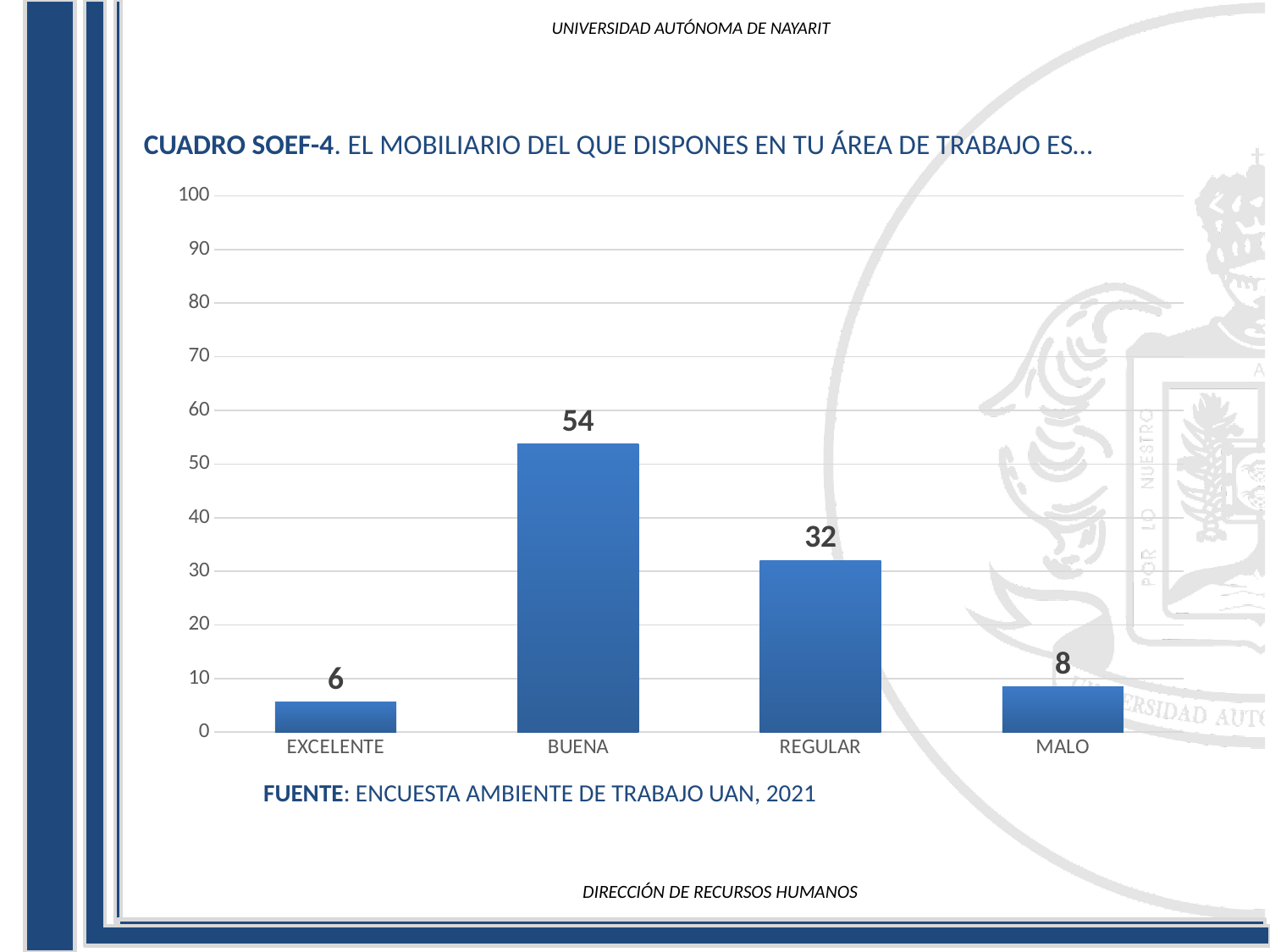
Is the value for REGULAR greater or less than 40? less What is the value for EXCELENTE? 6 Which category has the lowest value? EXCELENTE What is the value for REGULAR? 32 What is the value for BUENA? 54 What kind of chart is shown on the slide? bar chart How many categories are shown on the x axis? 4 What is the difference between the values for BUENA and REGULAR? 22 Which is larger, the value for MALO or the value for EXCELENTE? MALO What is the value for MALO? 8 What is the source cited below the chart? ENCUESTA AMBIENTE DE TRABAJO UAN, 2021 Which category has the highest value? BUENA